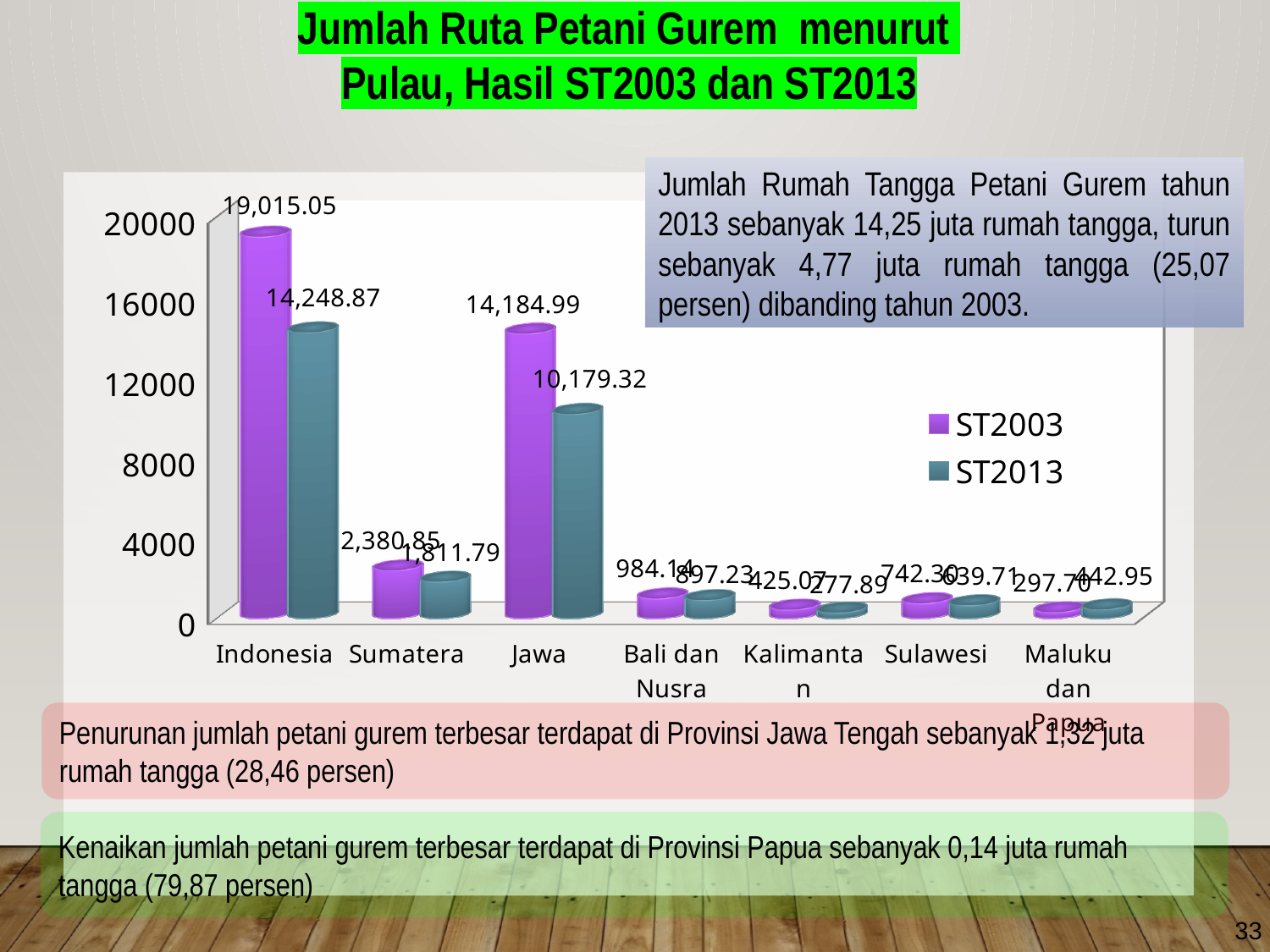
Is the ST2003 value for Kalimantan greater or less than 4000? less What is the difference between the ST2003 and ST2013 values for Indonesia? 4,766.18 What is the ST2013 value for Sumatera? 1,811.79 Which category has the highest ST2003 value? Indonesia What is the ST2003 value for Jawa? 14,184.99 Which is larger, the ST2003 value for Jawa or the ST2003 value for Sumatera? Jawa How many categories are shown on the x axis of the chart? 7 What kind of chart is shown on the slide? bar chart How many series does the legend list? 2 What is the ST2003 value for Indonesia? 19,015.05 What is the ST2013 value for Indonesia? 14,248.87 What is the ST2013 value for Jawa? 10,179.32